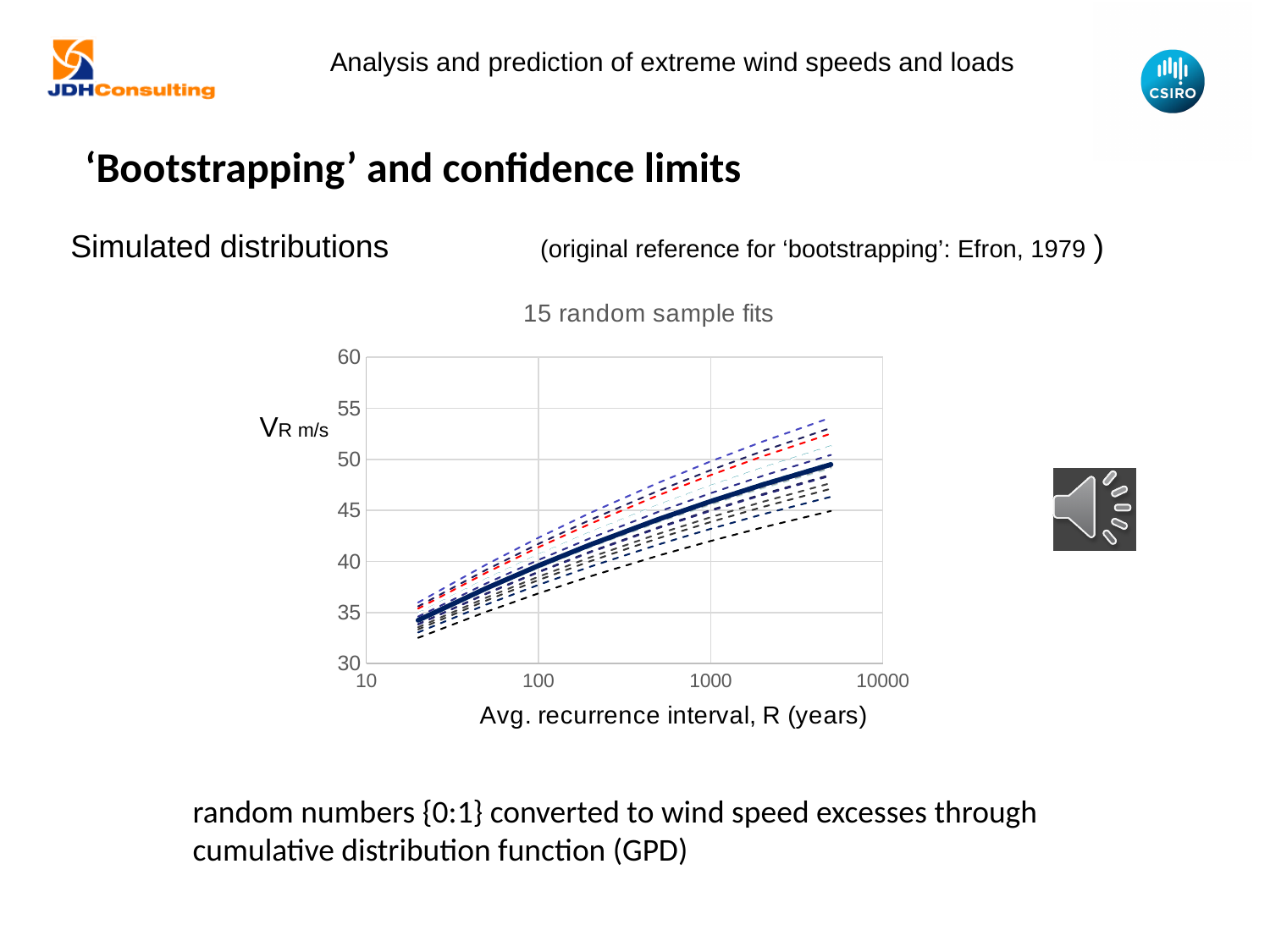
Do the plotted lines rise or fall as the average recurrence interval R increases? rise What kind of chart is shown on the slide? line chart Is the value of the thick solid line at its left-hand end (R = 20 years) greater or less than 40? less What is the title of the chart? 15 random sample fits What is the label of the x axis of the chart? Avg. recurrence interval, R (years) Is the highest dashed line at its right-hand end greater or less than 50? greater Is the value of the thick solid line at R = 1000 years greater or less than 40? greater What is the maximum value shown on the y axis of the chart? 60